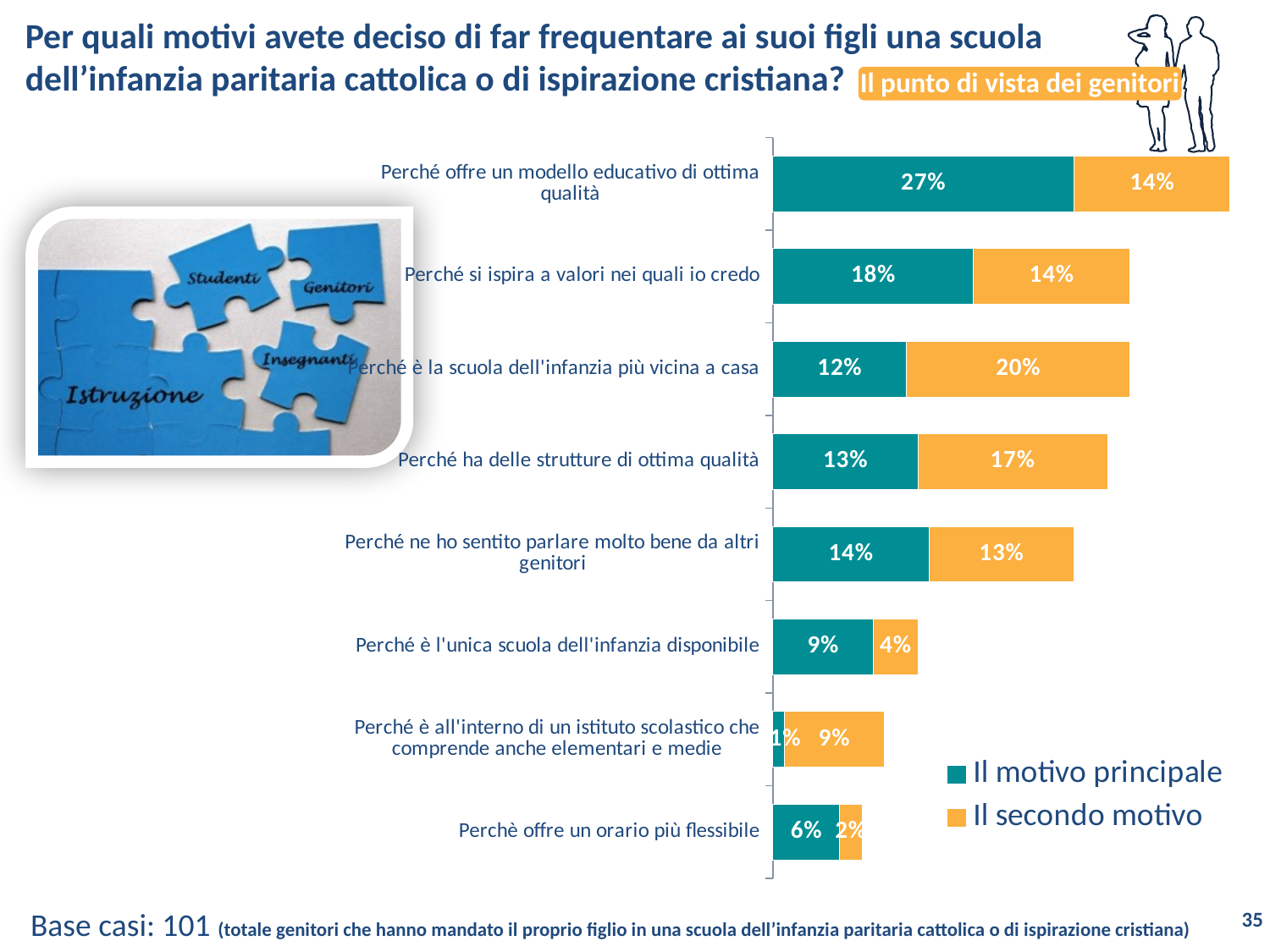
What is the difference between 'Il motivo principale' and 'Il secondo motivo' for 'Perché offre un modello educativo di ottima qualità'? 13% Which category has the highest value for 'Il motivo principale'? Perché offre un modello educativo di ottima qualità What colour represents 'Il secondo motivo' in the chart? Orange What is the total of the stacked bar for 'Perché ne ho sentito parlare molto bene da altri genitori'? 27% What is the value of 'Il motivo principale' for 'Perché offre un modello educativo di ottima qualità'? 27% For 'Perché si ispira a valori nei quali io credo', which is larger: 'Il motivo principale' or 'Il secondo motivo'? Il motivo principale Which category has the highest value for 'Il secondo motivo'? Perché è la scuola dell'infanzia più vicina a casa What kind of chart is shown on the slide? Stacked bar chart What is the value of 'Il motivo principale' for 'Perché ha delle strutture di ottima qualità'? 13% What is the value of 'Il secondo motivo' for 'Perché è la scuola dell'infanzia più vicina a casa'? 20% How many series does the legend list? 2 How many categories (reasons) are plotted in the chart? 8